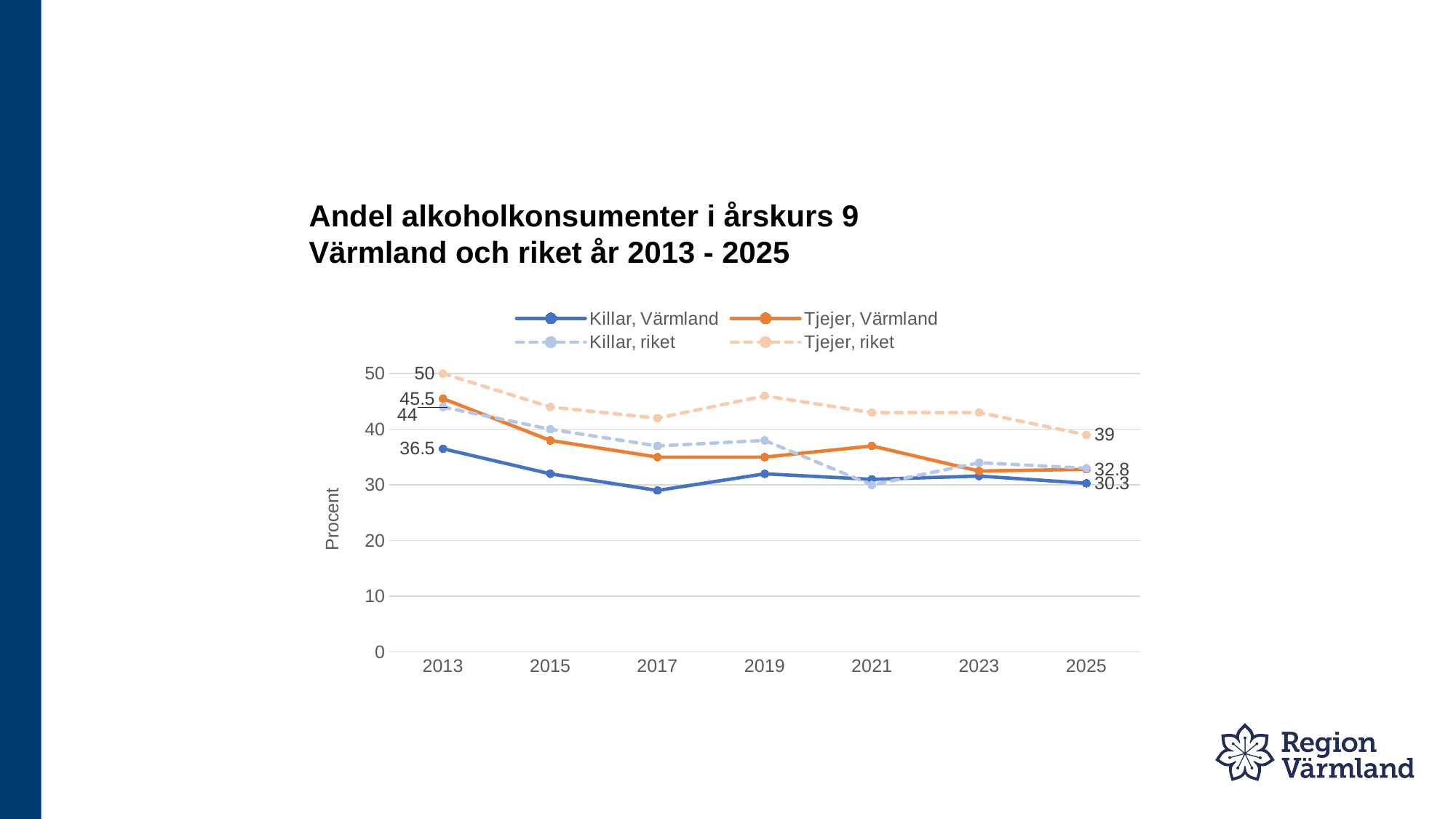
What is the value for Tjejer, riket in 2025? 39 Which series has the lowest value in 2013? Killar, Värmland Is the value for Killar, Värmland in 2017 greater or less than 30? less How many years are plotted along the x axis? 7 How many series does the legend list? 4 Does the value for Tjejer, riket rise or fall from 2013 to 2025? fall What is the value for Killar, Värmland in 2025? 30.3 By how much did the value for Tjejer, riket fall from 2013 to 2025? 11 What kind of chart is shown on the slide? Line chart What is the difference between Tjejer, Värmland and Killar, Värmland in 2013? 9 What is the value for Killar, Värmland in 2013? 36.5 Which series has the highest value in 2013? Tjejer, riket